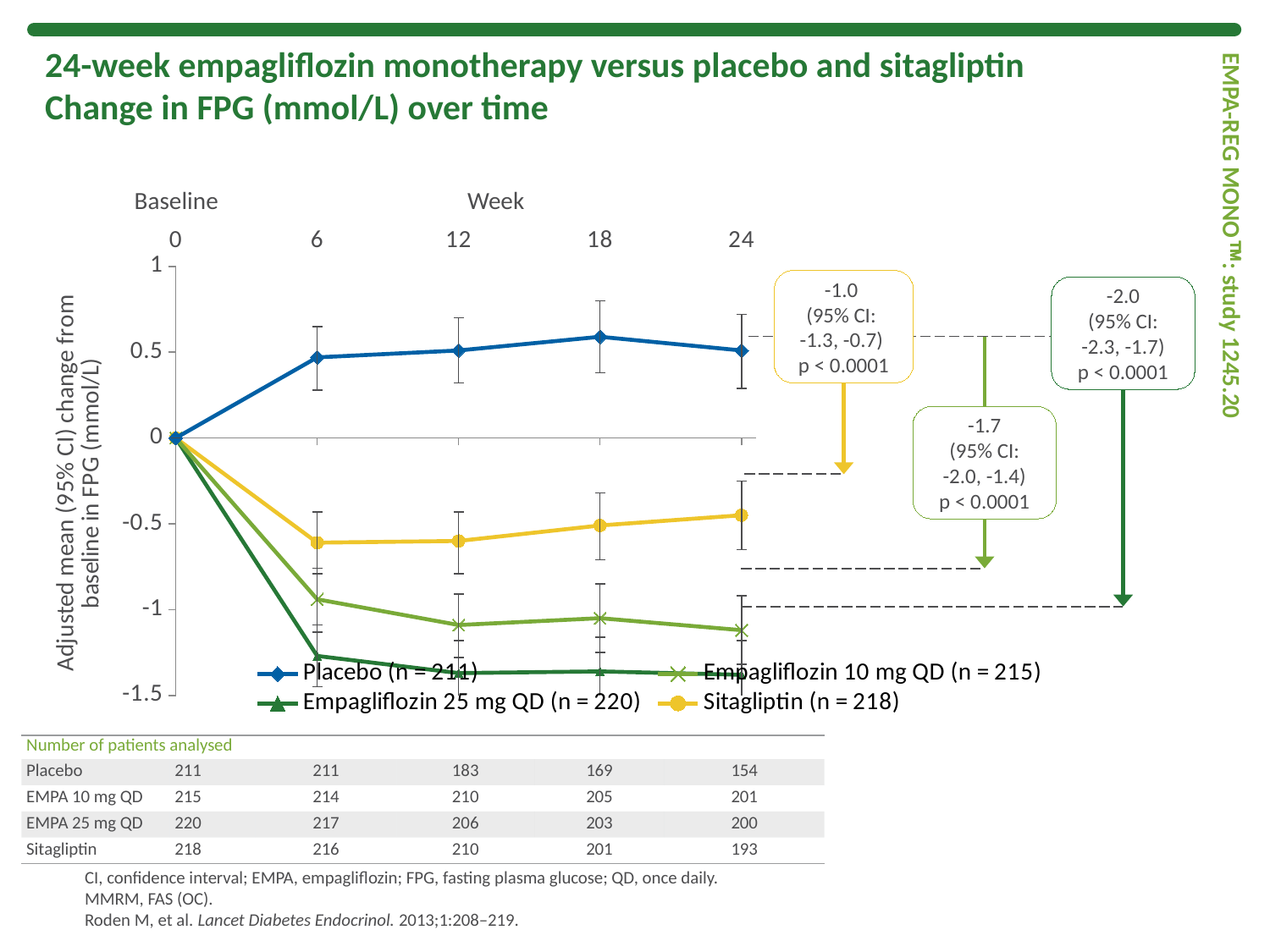
How many series does the legend list? 4 Does the placebo line rise or fall from baseline to week 6? rise Is the value for empagliflozin 25 mg QD at week 24 greater or less than -1? less According to the legend, how many patients were in the sitagliptin group? 218 How many time points are plotted along the x axis? 5 What kind of chart is shown on the slide? line chart What is the difference versus placebo at week 24 for empagliflozin 25 mg QD, as shown in the callout? -2.0 What is the 95% CI shown for the -1.7 difference versus placebo (empagliflozin 10 mg QD)? -2.0, -1.4 Is the value for placebo at week 24 greater or less than 0? greater Which treatment group shows the lowest (most negative) change from baseline in FPG at week 24? Empagliflozin 25 mg QD Which treatment group shows the highest change from baseline in FPG at week 24? Placebo What is the difference versus placebo at week 24 for sitagliptin, as shown in the callout? -1.0